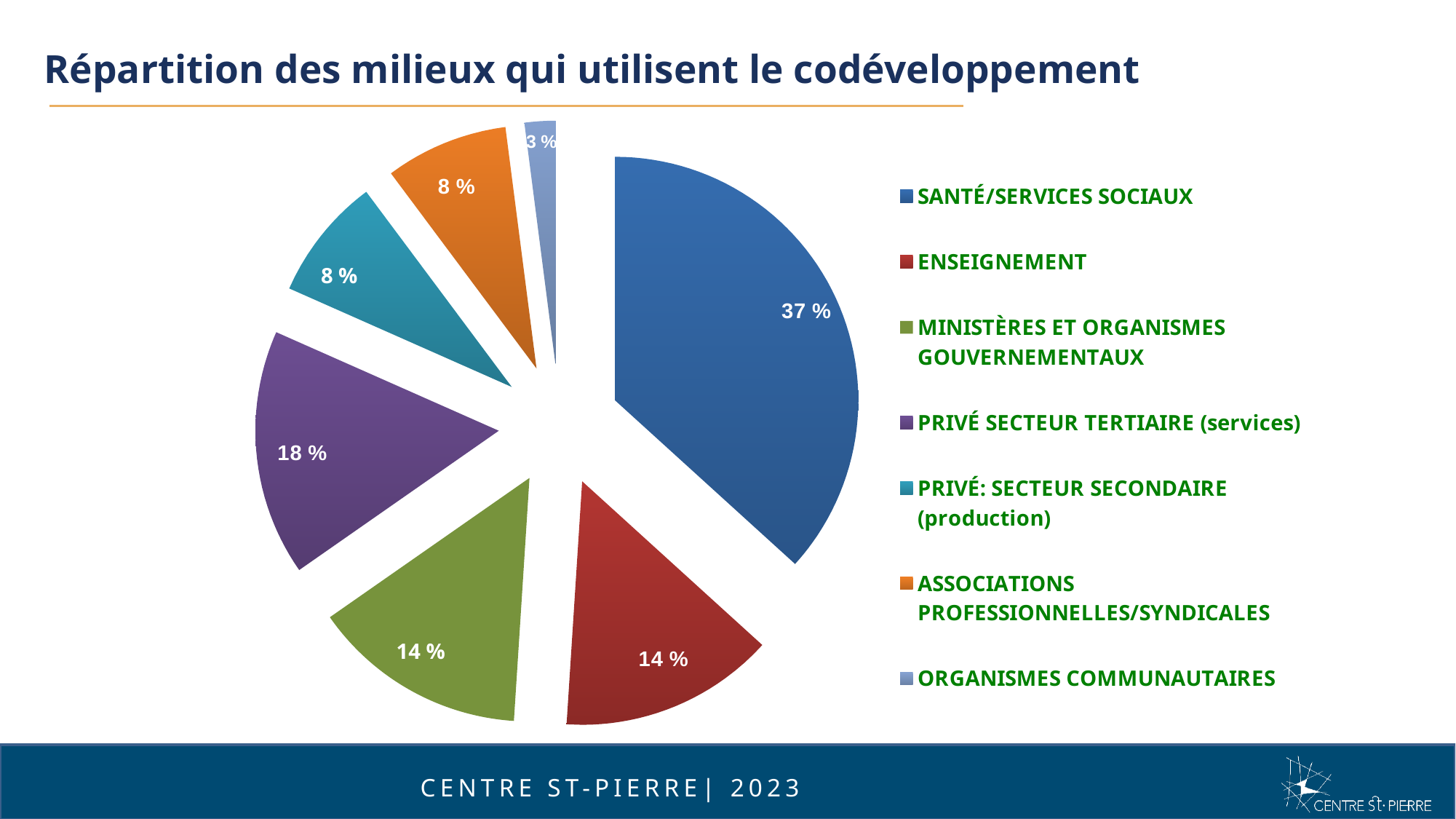
Which is larger, the share for MINISTÈRES ET ORGANISMES GOUVERNEMENTAUX or the share for PRIVÉ: SECTEUR SECONDAIRE (production)? MINISTÈRES ET ORGANISMES GOUVERNEMENTAUX How many categories does the legend list? 7 What is the value for ORGANISMES COMMUNAUTAIRES? 3 % Which category has the largest share of the pie? SANTÉ/SERVICES SOCIAUX What share of the pie is SANTÉ/SERVICES SOCIAUX? 37 % What is the value for ASSOCIATIONS PROFESSIONNELLES/SYNDICALES? 8 % What share of the pie is PRIVÉ SECTEUR TERTIAIRE (services)? 18 % Which category has the smallest share of the pie? ORGANISMES COMMUNAUTAIRES What is the title of the chart? Répartition des milieux qui utilisent le codéveloppement What is the value for ENSEIGNEMENT? 14 % What kind of chart is shown on the slide? pie chart What is the difference between the share for SANTÉ/SERVICES SOCIAUX and the share for PRIVÉ SECTEUR TERTIAIRE (services)? 19 %